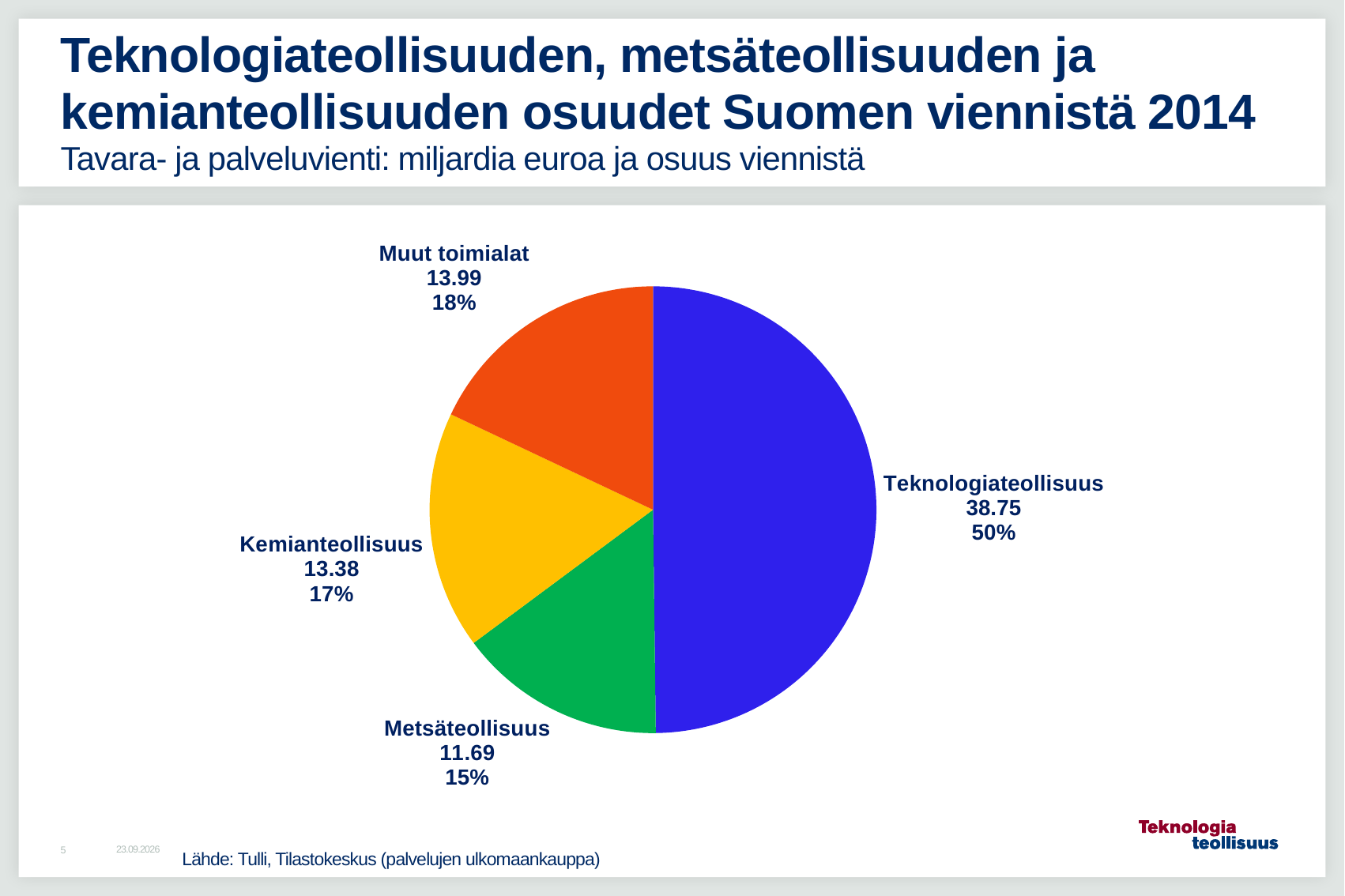
Which is larger, the value for Muut toimialat or the value for Kemianteollisuus? Muut toimialat Which category has the smallest slice of the pie? Metsäteollisuus How many slices does the pie chart have? 4 What is the difference between the values for Teknologiateollisuus and Metsäteollisuus? 27.06 What share of the pie does Teknologiateollisuus represent? 50% What colour is the Teknologiateollisuus slice? blue What is the value shown for Metsäteollisuus? 11.69 Which category has the largest slice of the pie? Teknologiateollisuus What share of the pie does Kemianteollisuus represent? 17% What type of chart is shown on the slide? pie chart What is the value shown for Muut toimialat? 13.99 What is the value shown for Teknologiateollisuus? 38.75